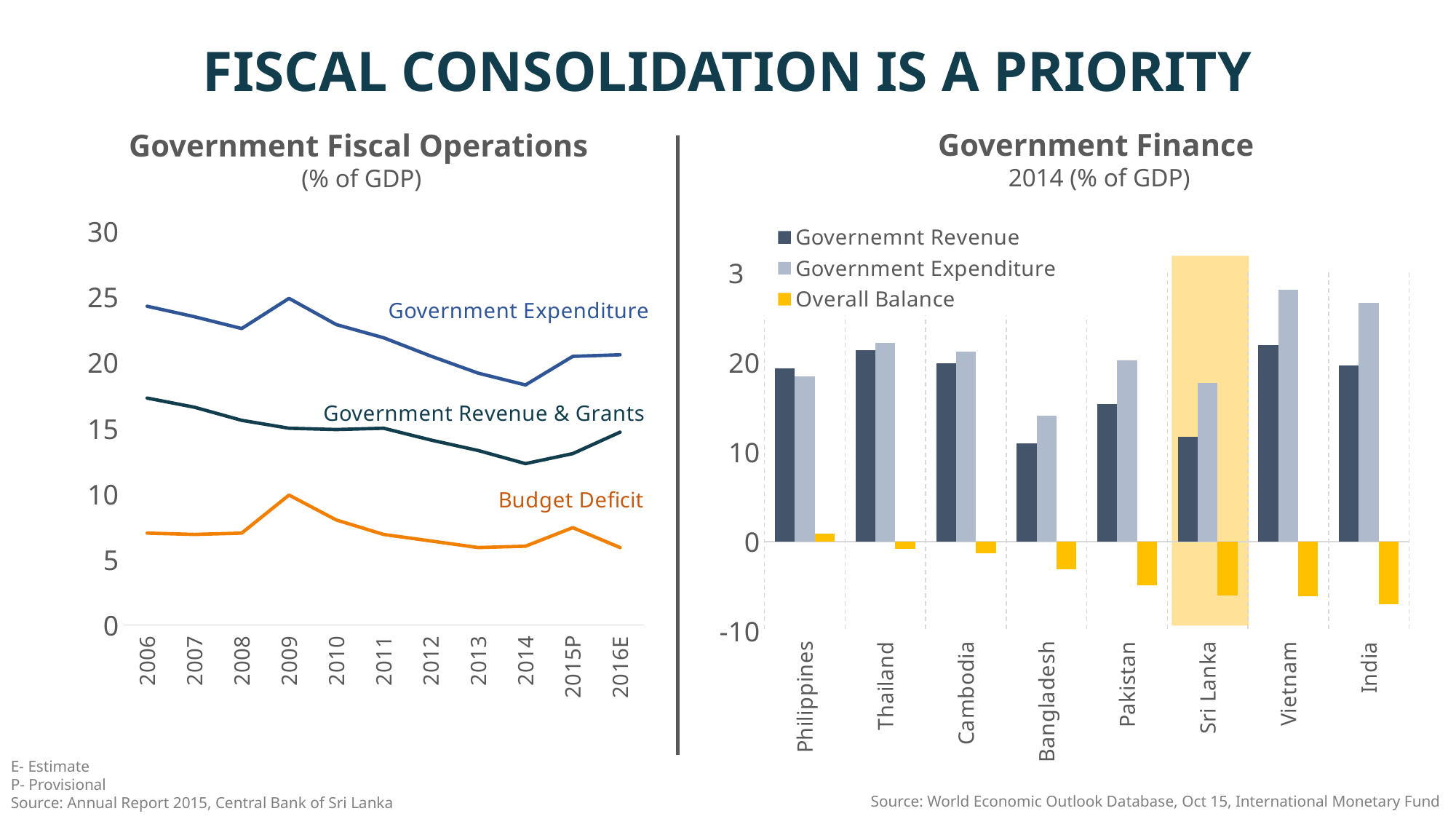
What kind of chart is the Government Fiscal Operations chart on the left? line chart In the Government Fiscal Operations chart, is the Government Expenditure value for 2009 greater or less than 20? greater What kind of chart is the Government Finance chart on the right? bar chart In the Government Fiscal Operations chart, is the Budget Deficit value for 2014 greater or less than 10? less In the Government Finance chart, how many series does the legend list? 3 In the Government Finance chart, how many countries are shown? 8 In the Government Fiscal Operations chart, how many years are shown on the x axis? 11 In the Government Fiscal Operations chart, in which year is Government Revenue & Grants at its lowest? 2014 In the Government Finance chart, which country has the highest Government Expenditure? Vietnam In the Government Finance chart, is the Government Expenditure value for Sri Lanka greater or less than 20? less In the Government Fiscal Operations chart, does Government Expenditure rise or fall between 2009 and 2014? fall In the Government Fiscal Operations chart, in which year does Government Expenditure reach its highest value? 2009